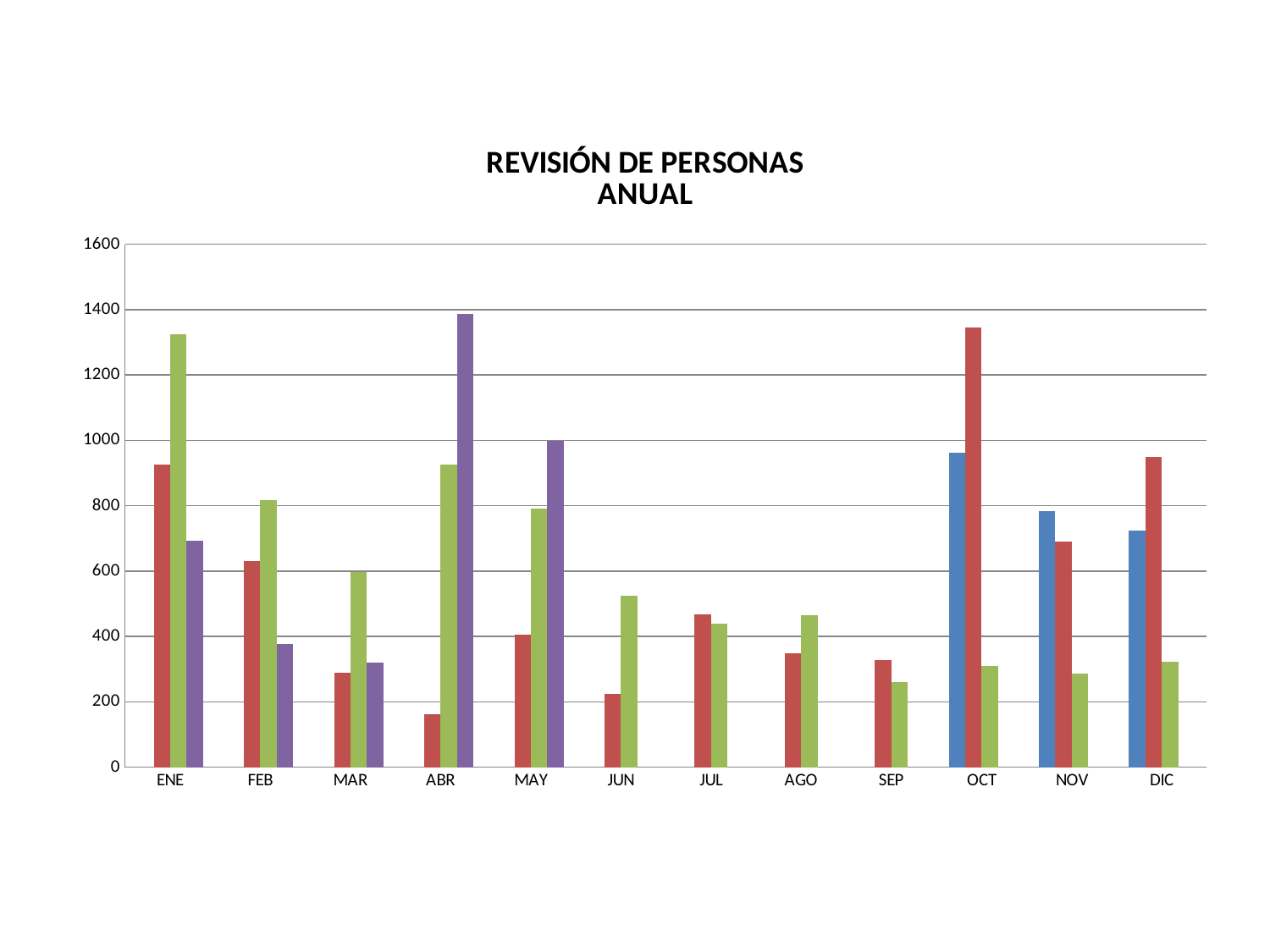
In which month is the red bar the shortest? ABR What is the title of the chart? REVISIÓN DE PERSONAS ANUAL Is the red bar for OCT greater or less than 1200? greater What kind of chart is shown on the slide? Bar chart How many months are shown on the x axis of the chart? 12 Is the red bar for ABR greater or less than 200? less Is the green bar for ENE greater or less than 1200? greater In which month is the green bar the tallest? ENE Which is taller, the red bar for ENE or the red bar for FEB? ENE Do the green bars rise or fall from ENE to MAR? fall